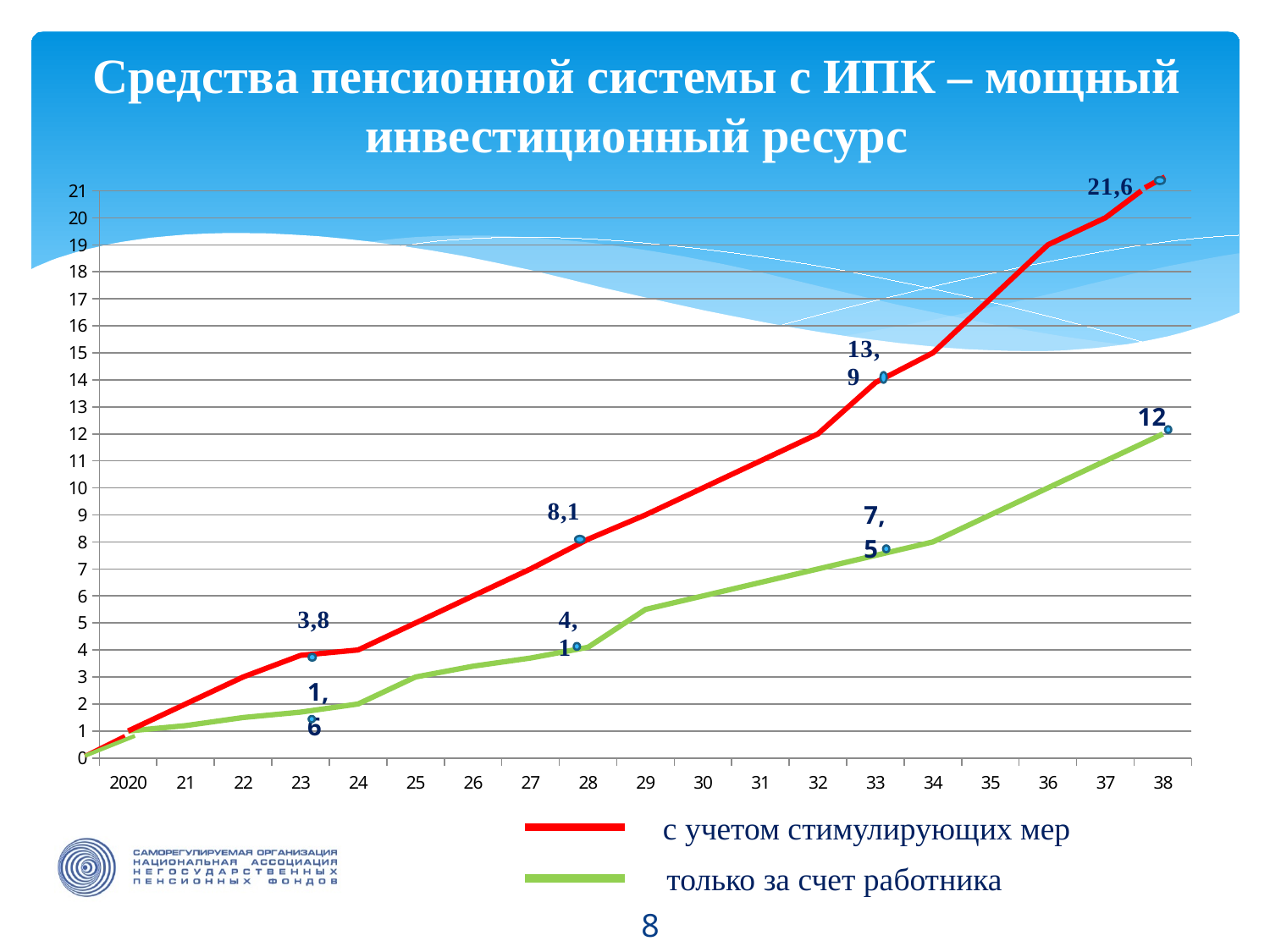
How many series does the legend list? 2 What is the difference between the two series in 2038? 9,6 What is the value of the 'только за счет работника' series in 2023? 1,6 What kind of chart is shown on the slide? line chart Is the value of the 'с учетом стимулирующих мер' series in 2036 greater or less than 18? greater What is the value of the 'только за счет работника' series in 2038? 12 Which series has the higher value in 2033? с учетом стимулирующих мер What is the value of the 'с учетом стимулирующих мер' series in 2028? 8,1 What is the value of the 'с учетом стимулирующих мер' series in 2038? 21,6 Which series is drawn in green? только за счет работника Do the values of the 'с учетом стимулирующих мер' series rise or fall from 2020 to 2038? rise What is the difference between the 'с учетом стимулирующих мер' and 'только за счет работника' values in 2028? 4